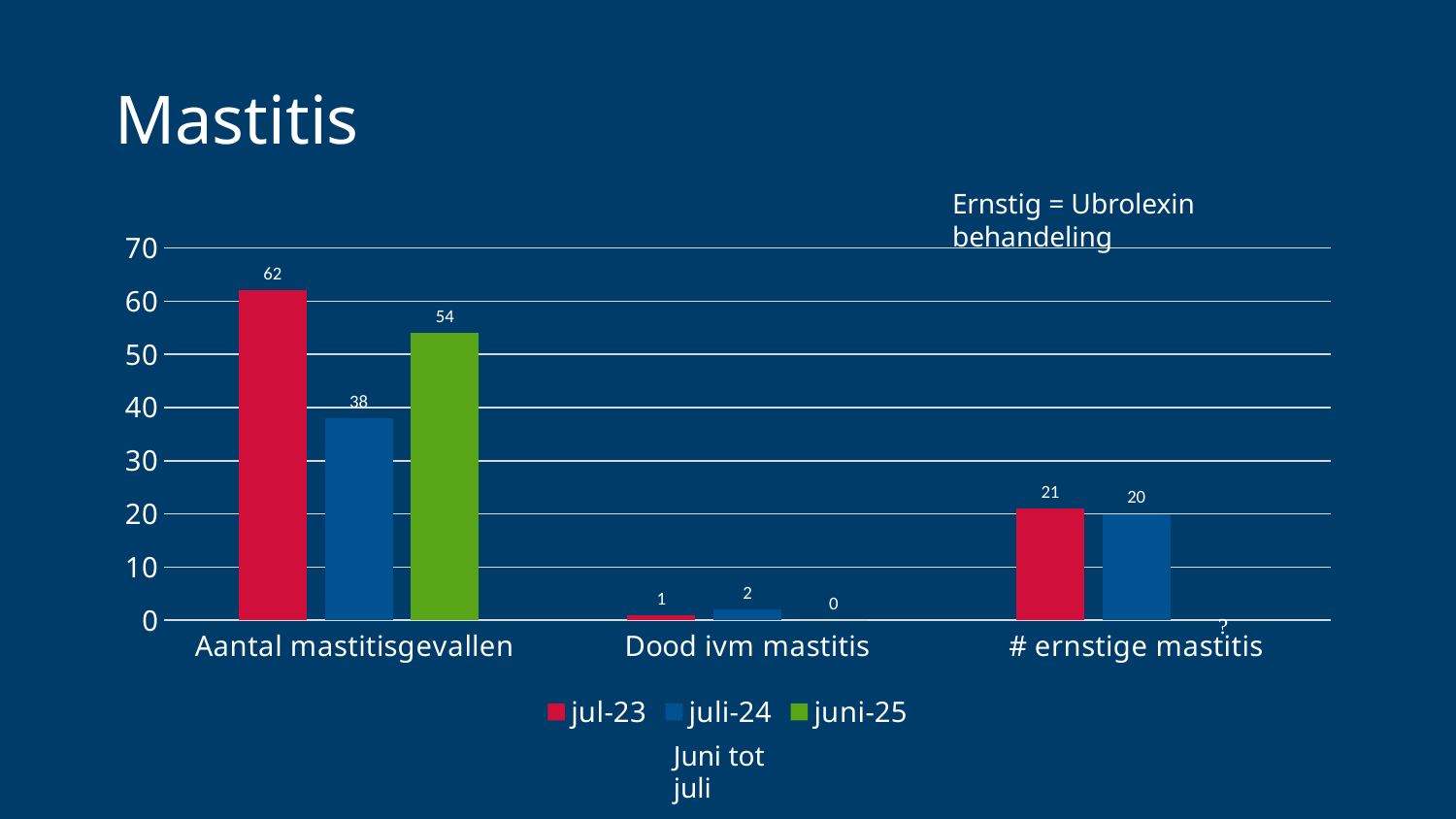
What kind of chart is shown on the slide? bar chart How many categories are shown on the x axis? 3 What is the difference between the jul-23 and juli-24 values in the Aantal mastitisgevallen category? 24 What is the value for juni-25 in the Aantal mastitisgevallen category? 54 Which series has the lowest value in the Dood ivm mastitis category? juni-25 What is the value for jul-23 in the Aantal mastitisgevallen category? 62 What is the value for jul-23 in the # ernstige mastitis category? 21 What is the value for juli-24 in the Aantal mastitisgevallen category? 38 Which is larger in the Aantal mastitisgevallen category: juli-24 or juni-25? juni-25 How many series does the legend list? 3 What is the value for juli-24 in the Dood ivm mastitis category? 2 Which series has the highest value in the Aantal mastitisgevallen category? jul-23